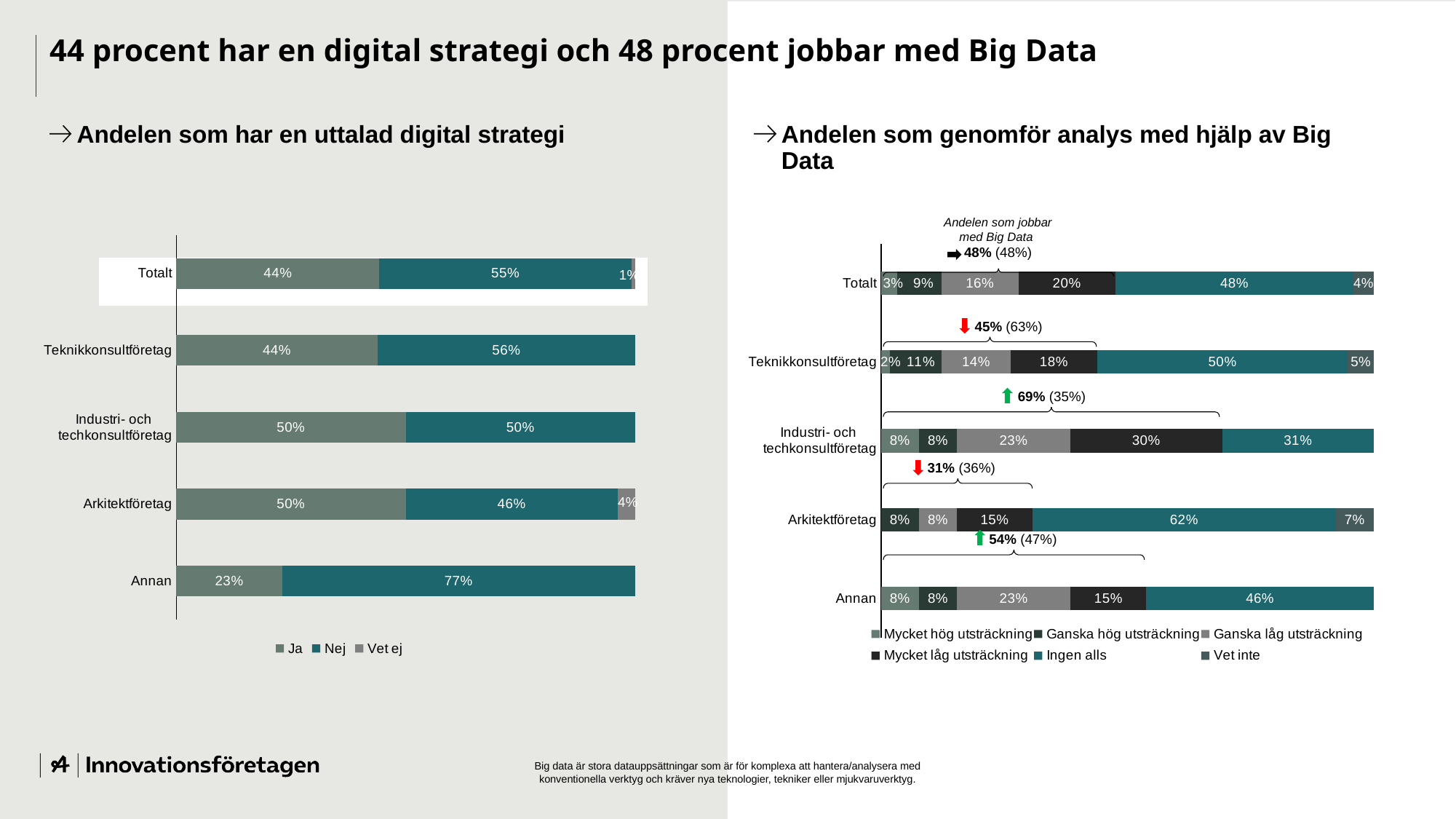
In the left chart 'Andelen som har en uttalad digital strategi', what is the 'Ja' value for Annan? 23% In the right chart 'Andelen som genomför analys med hjälp av Big Data', what is the 'Ingen alls' value for Arkitektföretag? 62% In the left chart 'Andelen som har en uttalad digital strategi', how many series does the legend list? 3 In the left chart 'Andelen som har en uttalad digital strategi', what is the difference between the 'Nej' and 'Ja' values for Annan? 54% In the right chart 'Andelen som genomför analys med hjälp av Big Data', how many series does the legend list? 6 In the left chart 'Andelen som har en uttalad digital strategi', which category has the highest 'Nej' value? Annan In the left chart 'Andelen som har en uttalad digital strategi', which category has the lowest 'Ja' value? Annan What kind of chart is the left chart 'Andelen som har en uttalad digital strategi'? Stacked bar chart In the right chart 'Andelen som genomför analys med hjälp av Big Data', which category has the highest 'Ingen alls' value? Arkitektföretag In the right chart 'Andelen som genomför analys med hjälp av Big Data', what is the 'Mycket låg utsträckning' value for Industri- och techkonsultföretag? 30% In the left chart 'Andelen som har en uttalad digital strategi', what is the 'Nej' value for Teknikkonsultföretag? 56% In the right chart 'Andelen som genomför analys med hjälp av Big Data', is the 'Ganska låg utsträckning' value larger for Totalt or for Teknikkonsultföretag? Totalt